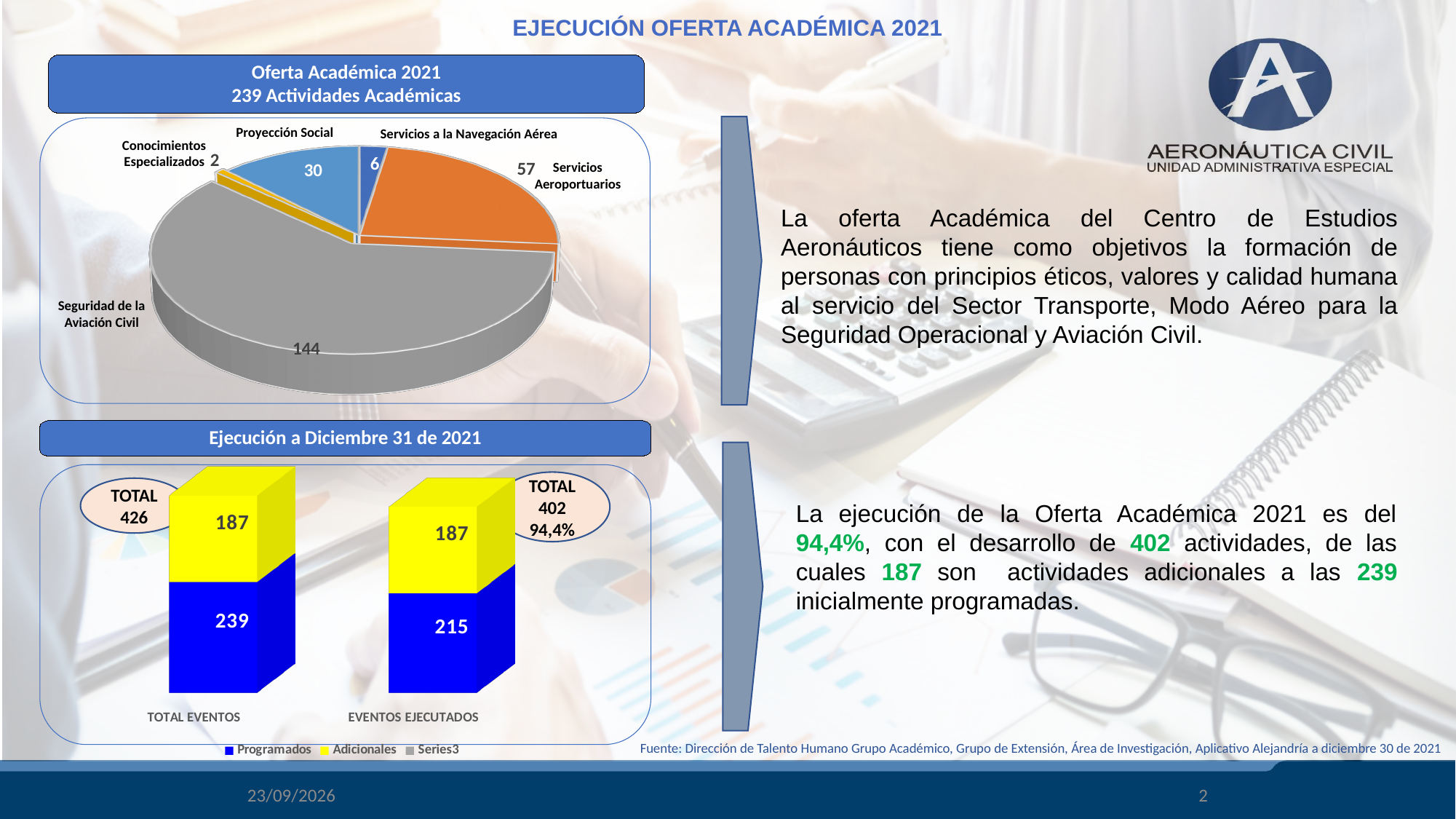
How many series does the legend of the bar chart 'Ejecución a Diciembre 31 de 2021' list? 3 In the pie chart 'Oferta Académica 2021', what is the value for Servicios Aeroportuarios? 57 In the bar chart 'Ejecución a Diciembre 31 de 2021', what is the total of the TOTAL EVENTOS stacked bar? 426 In the pie chart 'Oferta Académica 2021', what is the difference between Proyección Social and Servicios a la Navegación Aérea? 24 In the bar chart 'Ejecución a Diciembre 31 de 2021', which is larger: Programados for TOTAL EVENTOS or Programados for EVENTOS EJECUTADOS? TOTAL EVENTOS In the pie chart 'Oferta Académica 2021', which category has the largest value? Seguridad de la Aviación Civil In the bar chart 'Ejecución a Diciembre 31 de 2021', what is the Programados value for EVENTOS EJECUTADOS? 215 In the bar chart 'Ejecución a Diciembre 31 de 2021', what is the difference between the Programados values for TOTAL EVENTOS and EVENTOS EJECUTADOS? 24 In the pie chart 'Oferta Académica 2021', which category has the smallest value? Conocimientos Especializados In the pie chart 'Oferta Académica 2021', how many categories are shown? 5 What kind of chart is shown under 'Oferta Académica 2021'? Pie chart In the pie chart 'Oferta Académica 2021', what is the value for Seguridad de la Aviación Civil? 144